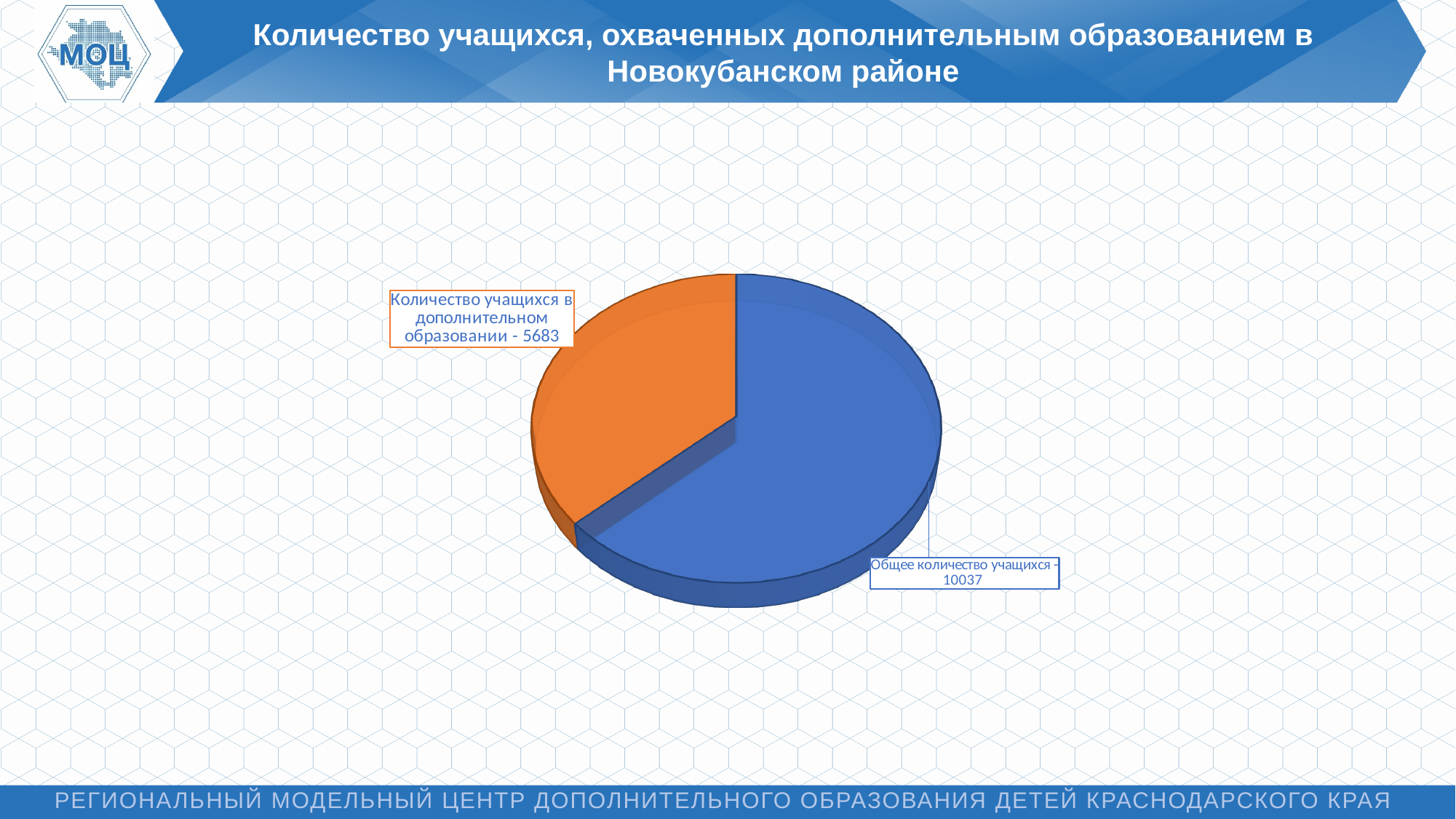
Which slice of the pie chart is the smallest? Количество учащихся в дополнительном образовании What is the title of the slide containing the chart? Количество учащихся, охваченных дополнительным образованием в Новокубанском районе How many slices does the pie chart have? 2 What colour is the slice for "Общее количество учащихся"? Blue What type of chart is shown on the slide? Pie chart What is the value for "Общее количество учащихся"? 10037 Which is larger: "Общее количество учащихся" or "Количество учащихся в дополнительном образовании"? Общее количество учащихся Which slice of the pie chart is the largest? Общее количество учащихся What is the value for "Количество учащихся в дополнительном образовании"? 5683 What is the difference between "Общее количество учащихся" and "Количество учащихся в дополнительном образовании"? 4354